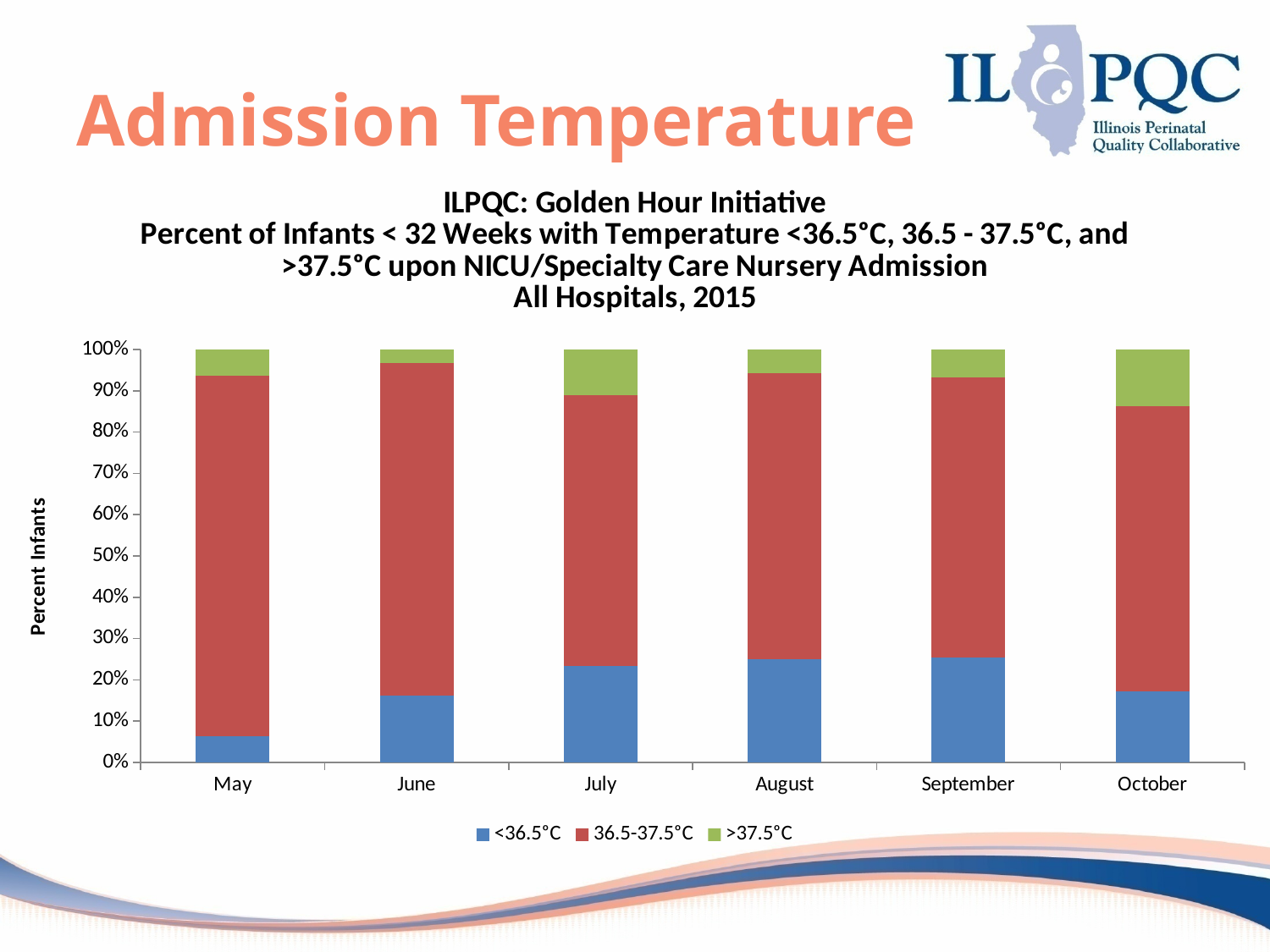
What is the label of the y axis? Percent Infants Which month has the lowest share of infants with temperature <36.5°C? May Is the value for <36.5°C in July greater or less than 20%? greater Is the value for <36.5°C in May greater or less than 10%? less Is the value for <36.5°C in June greater or less than 10%? greater Which month has the highest share of infants with temperature >37.5°C? October What is the total height of the stacked bar for May? 100% What kind of chart is shown on the slide? stacked bar chart How many series does the chart legend list? 3 Which month has the lowest share of infants with temperature >37.5°C? June Which is larger, the <36.5°C share in July or in May? July How many months are shown on the x axis of the chart? 6